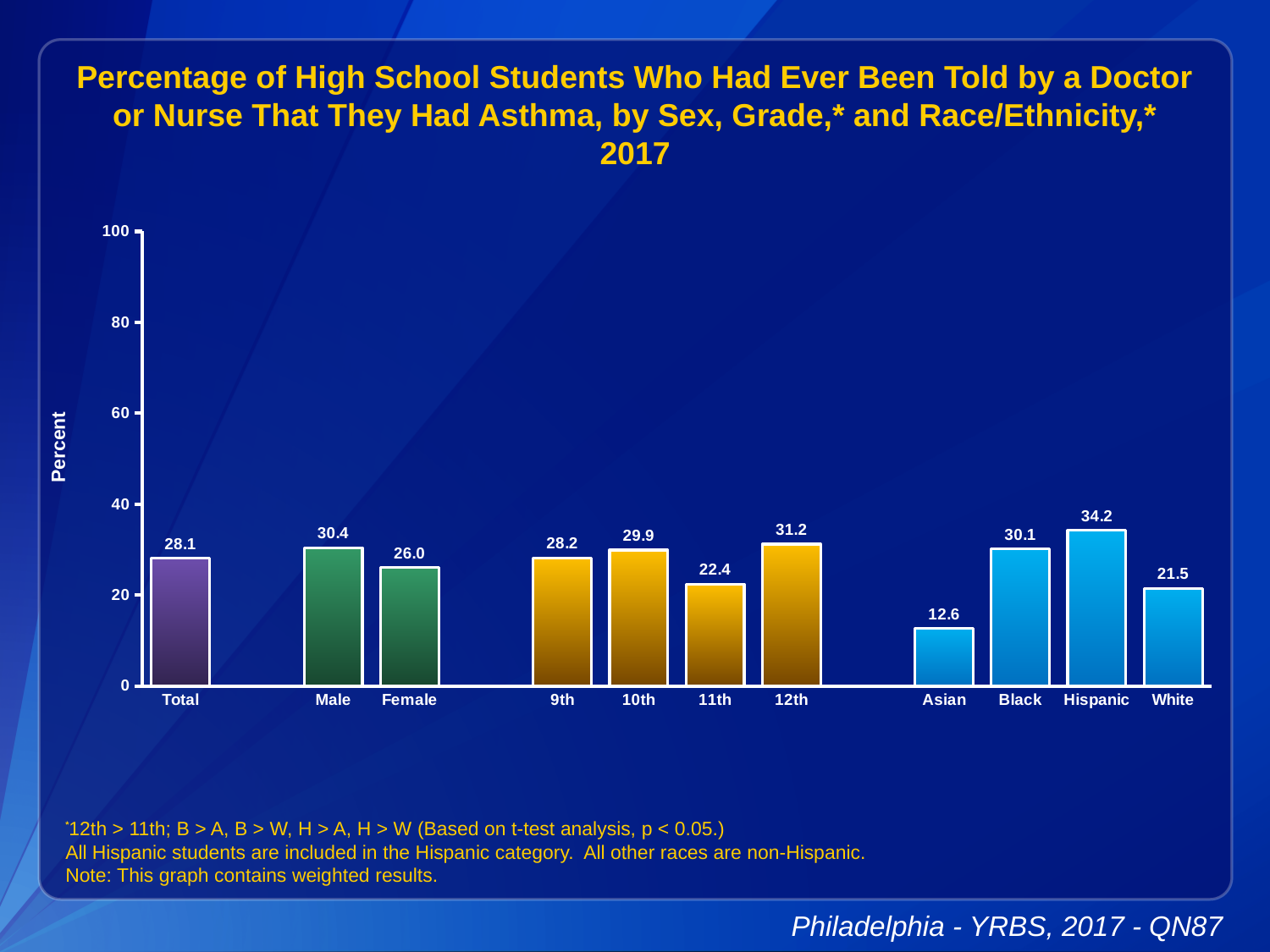
How many categories are plotted on the chart? 11 Which category has the lowest value? Asian Which is larger, the value for Black or the value for White? Black What is the value for 11th grade? 22.4 Which category has the highest value? Hispanic What is the difference between the Male and Female values? 4.4 What is the value for Female? 26.0 What is the value for Asian students? 12.6 What is the label of the y axis? Percent What is the value for Total? 28.1 What is the difference between the 12th grade and 11th grade values? 8.8 What kind of chart is shown? Bar chart